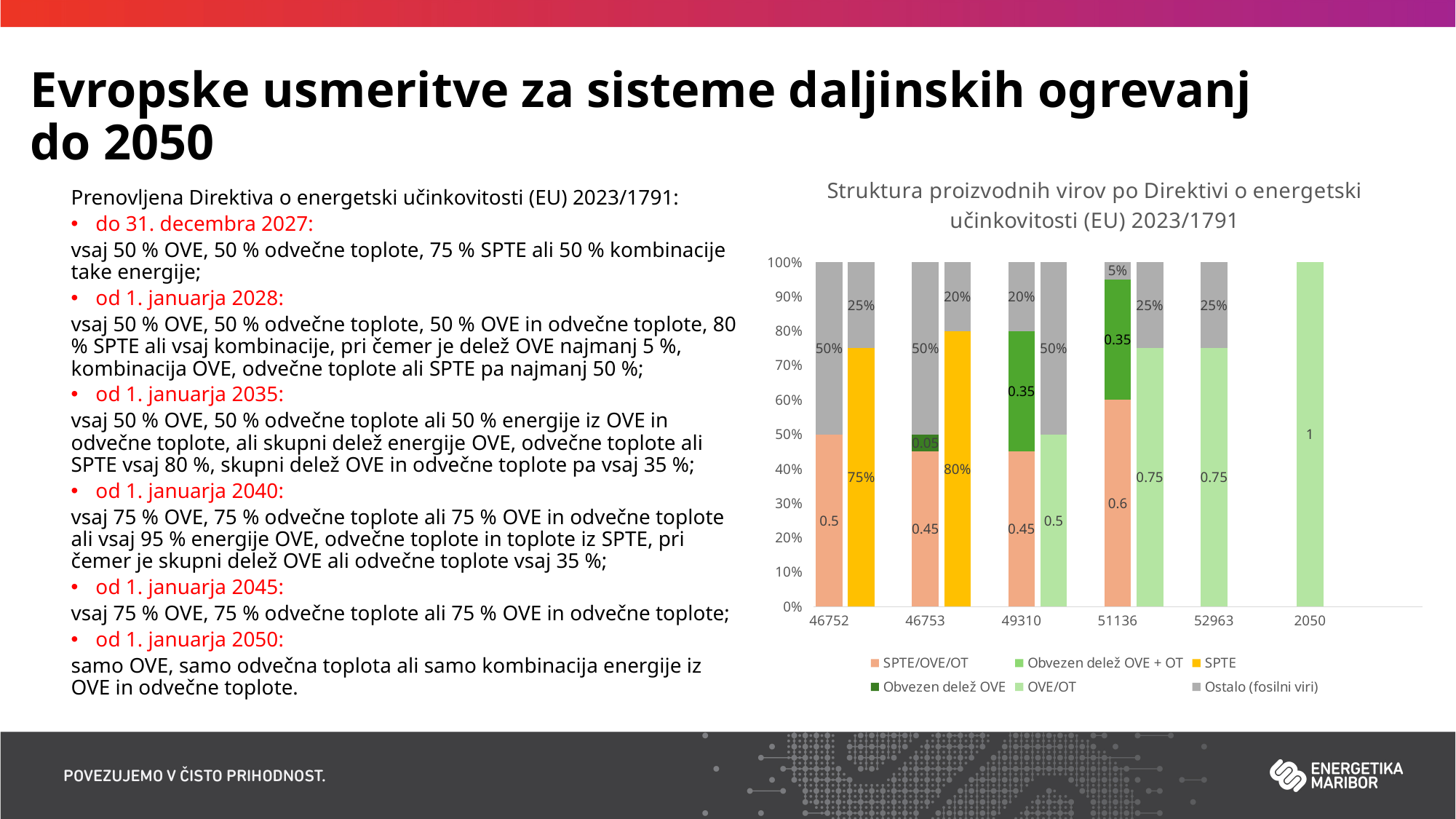
Which is larger: the SPTE value in the second bar of 46752 or the SPTE value in the second bar of 46753? 46753 What kind of chart is shown on the slide? stacked bar chart What is the title of the chart? Struktura proizvodnih virov po Direktivi o energetski učinkovitosti (EU) 2023/1791 How many categories are shown on the x axis of the chart? 6 What is the SPTE value labelled on the second bar of category 46753? 80% What is the Ostalo (fosilni viri) value labelled on the first bar of category 51136? 5% How many series does the chart legend list? 6 What is the SPTE/OVE/OT value labelled on the first bar of category 51136? 0.6 What is the SPTE value labelled on the second bar of category 46752? 75% What is the OVE/OT value labelled for category 52963? 0.75 What is the OVE/OT value labelled for category 2050? 1